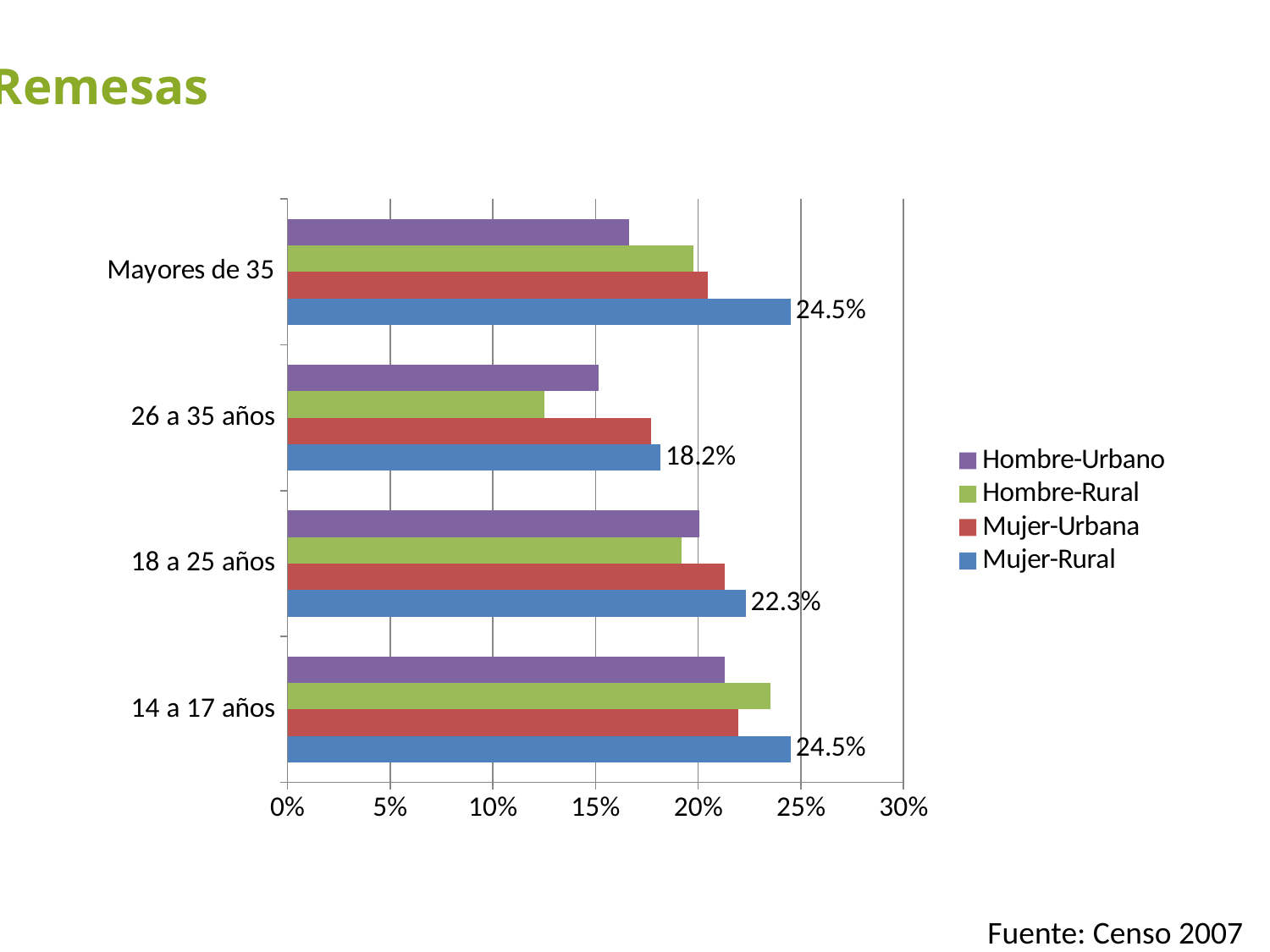
Among the Mujer-Rural bars, which age category has the lowest value? 26 a 35 años What is the difference between the Mujer-Rural values for Mayores de 35 and 26 a 35 años? 6.3 percentage points What kind of chart is shown on the slide? Bar chart In the 26 a 35 años category, which is larger: Hombre-Urbano or Hombre-Rural? Hombre-Urbano What is the value for Mujer-Rural in the 26 a 35 años category? 18.2% Is the value for Hombre-Rural in the 26 a 35 años category greater or less than 15%? less Is the value for Hombre-Rural in the 14 a 17 años category greater or less than 20%? greater What source is cited for the chart data? Censo 2007 What is the value for Mujer-Rural in the 18 a 25 años category? 22.3% What is the value for Mujer-Rural in the Mayores de 35 category? 24.5% How many age categories are shown on the chart? 4 How many series does the legend list? 4